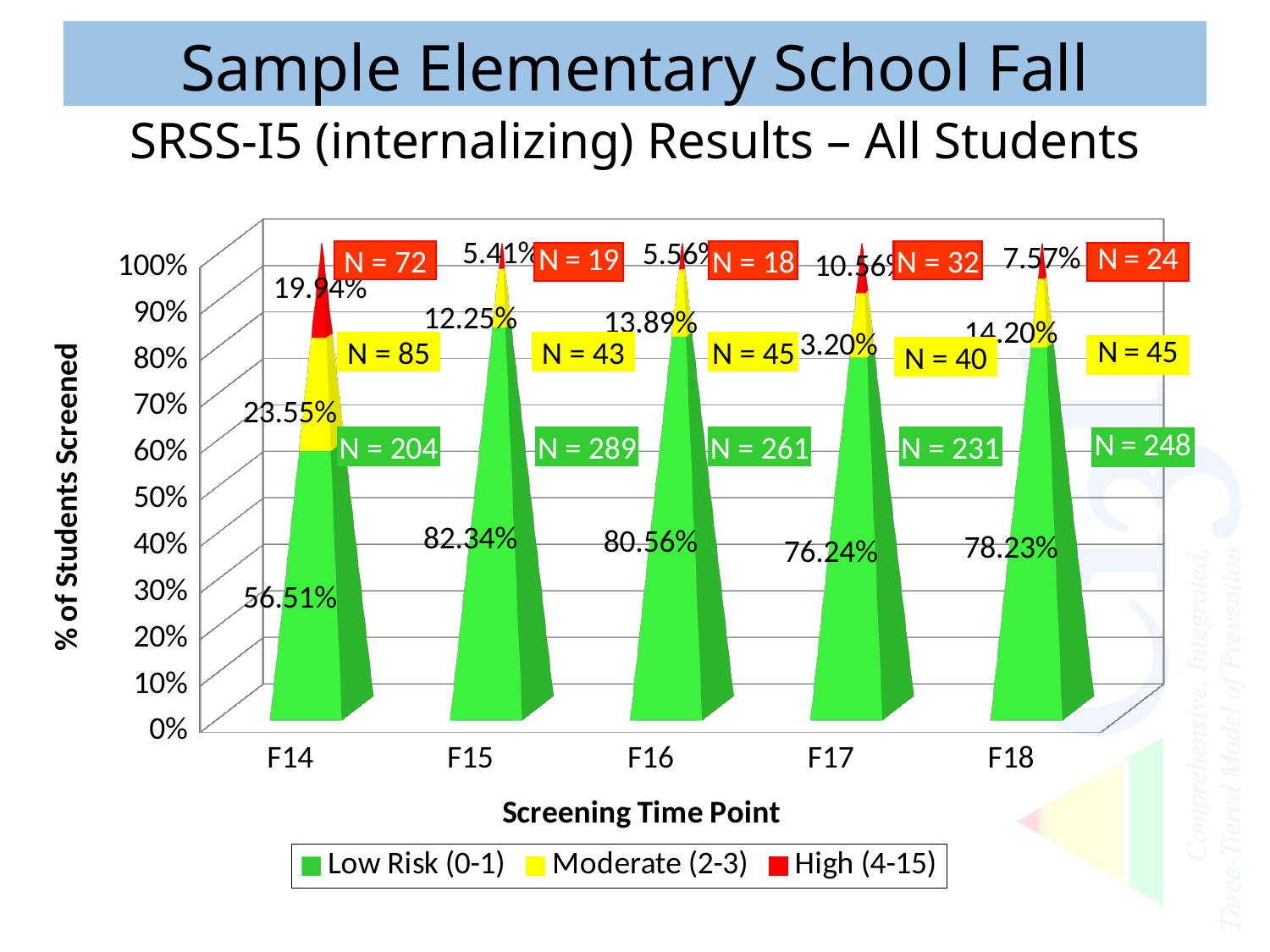
What percentage of students were in the High (4-15) category at F14? 19.94% How many students (N) were in the Low Risk (0-1) category at F16? 261 What is the label of the y axis? % of Students Screened What percentage of students were in the Moderate (2-3) category at F18? 14.20% What percentage of students were in the Low Risk (0-1) category at F15? 82.34% How many series does the legend list? 3 By how many percentage points did the Low Risk (0-1) share increase from F14 to F15? 25.83 percentage points What percentage of students were in the Low Risk (0-1) category at F14? 56.51% Which screening time point has the lowest Low Risk (0-1) percentage? F14 Which screening time point has the highest Low Risk (0-1) percentage? F15 Which time point has a larger High (4-15) percentage, F14 or F17? F14 How many screening time points are shown on the x axis? 5